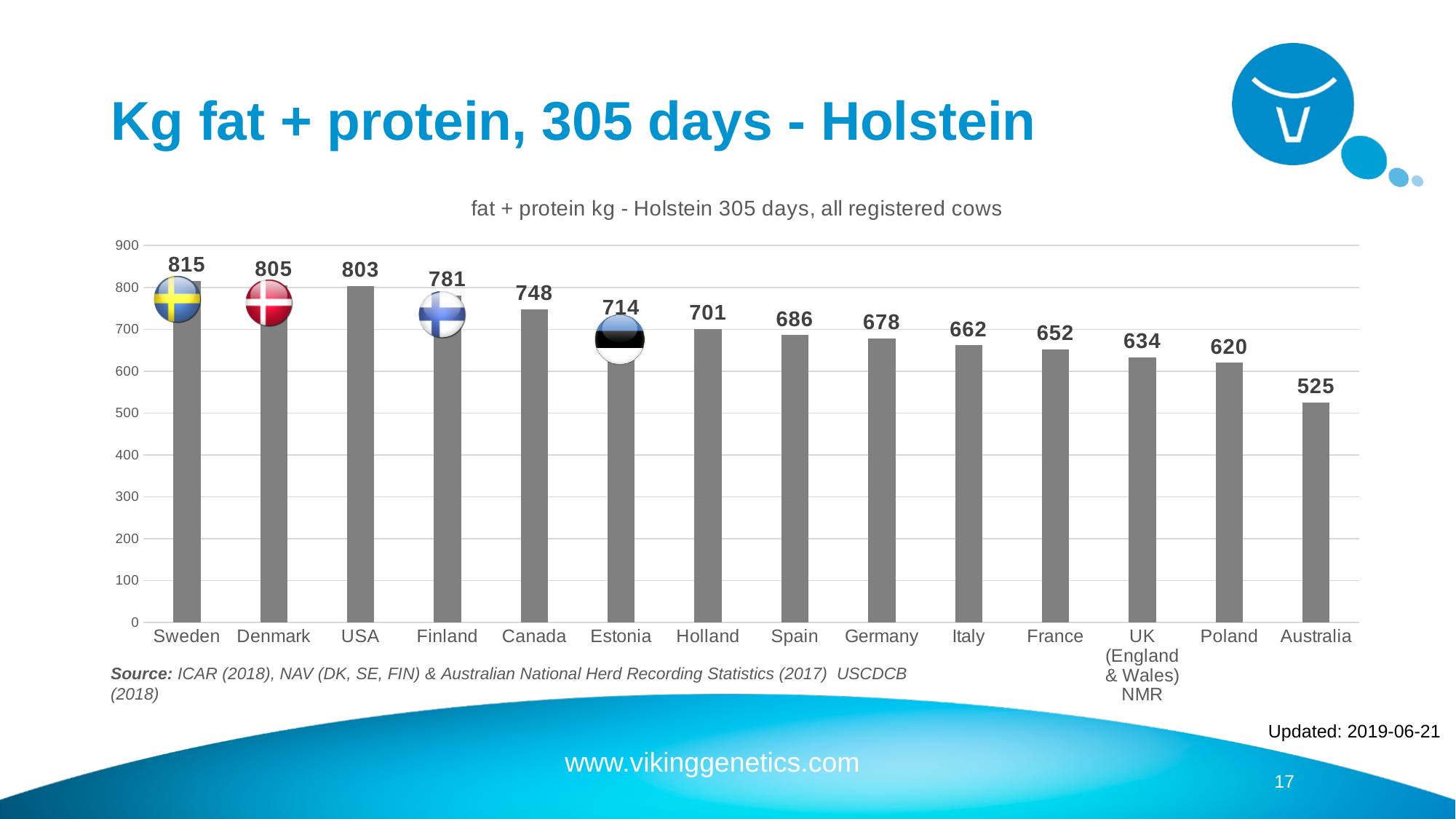
Which country has the lowest value? Australia How many countries are shown on the chart? 14 Which country has the highest value? Sweden Which is larger, the value for Holland or the value for Spain? Holland What is the value for Sweden? 815 What is the difference between the values for Sweden and Australia? 290 What is the value for Canada? 748 Is the value for Poland greater or less than 600? greater Do the values rise or fall from left to right along the x axis? Fall What is the value for UK (England & Wales) NMR? 634 What is the difference between the values for Denmark and Finland? 24 What kind of chart is shown on the slide? Bar chart